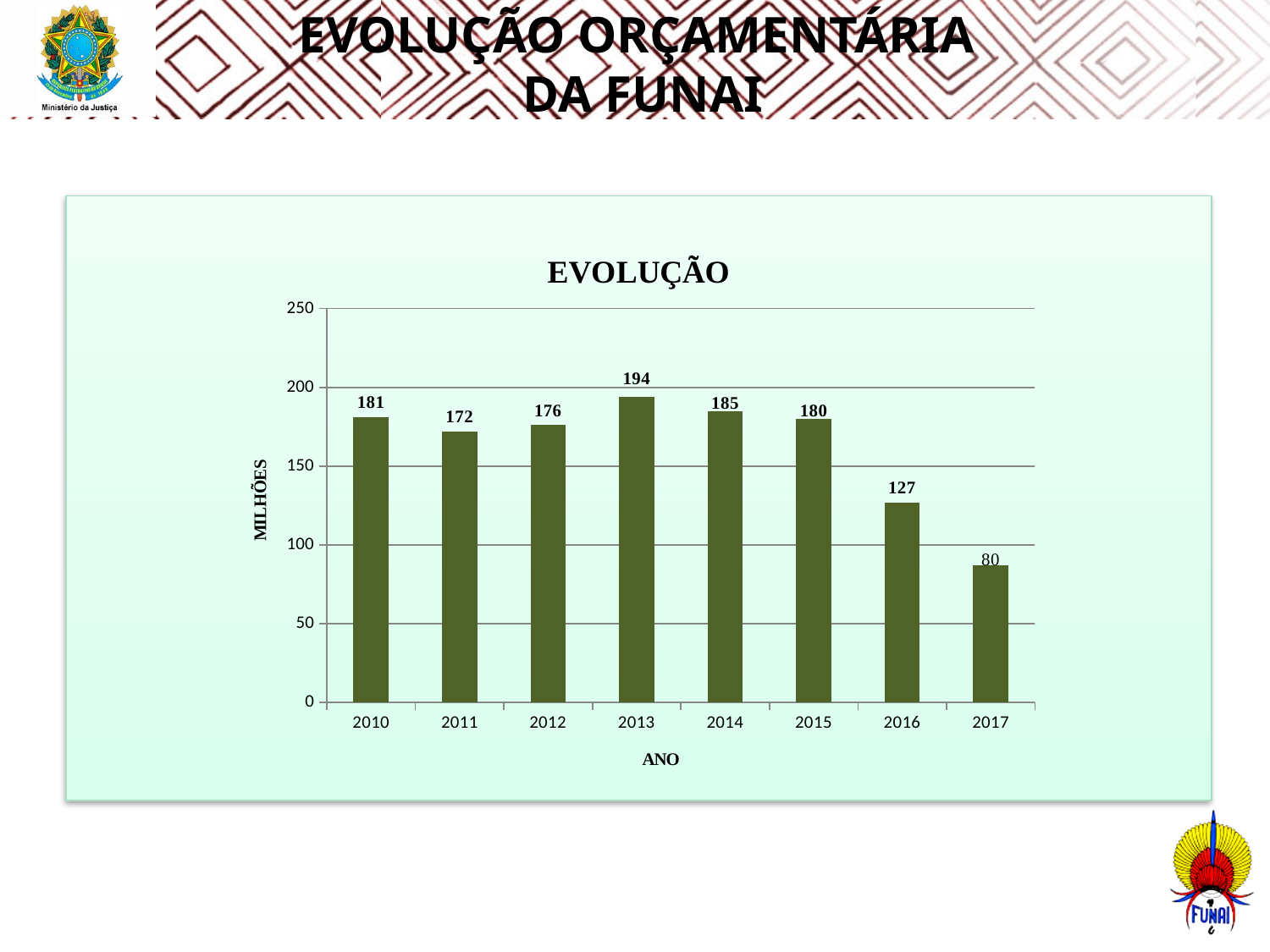
What is the value for 2016? 127 What is the value for 2011? 172 Which is larger, the value for 2010 or the value for 2012? 2010 Which year has the lowest value? 2017 Is the value for 2017 greater or less than 100? less What is the difference between the values for 2015 and 2016? 53 Which year has the highest value? 2013 What is the label of the y axis? MILHÕES What is the value for 2013? 194 What kind of chart is shown? bar chart How many years are shown on the x axis? 8